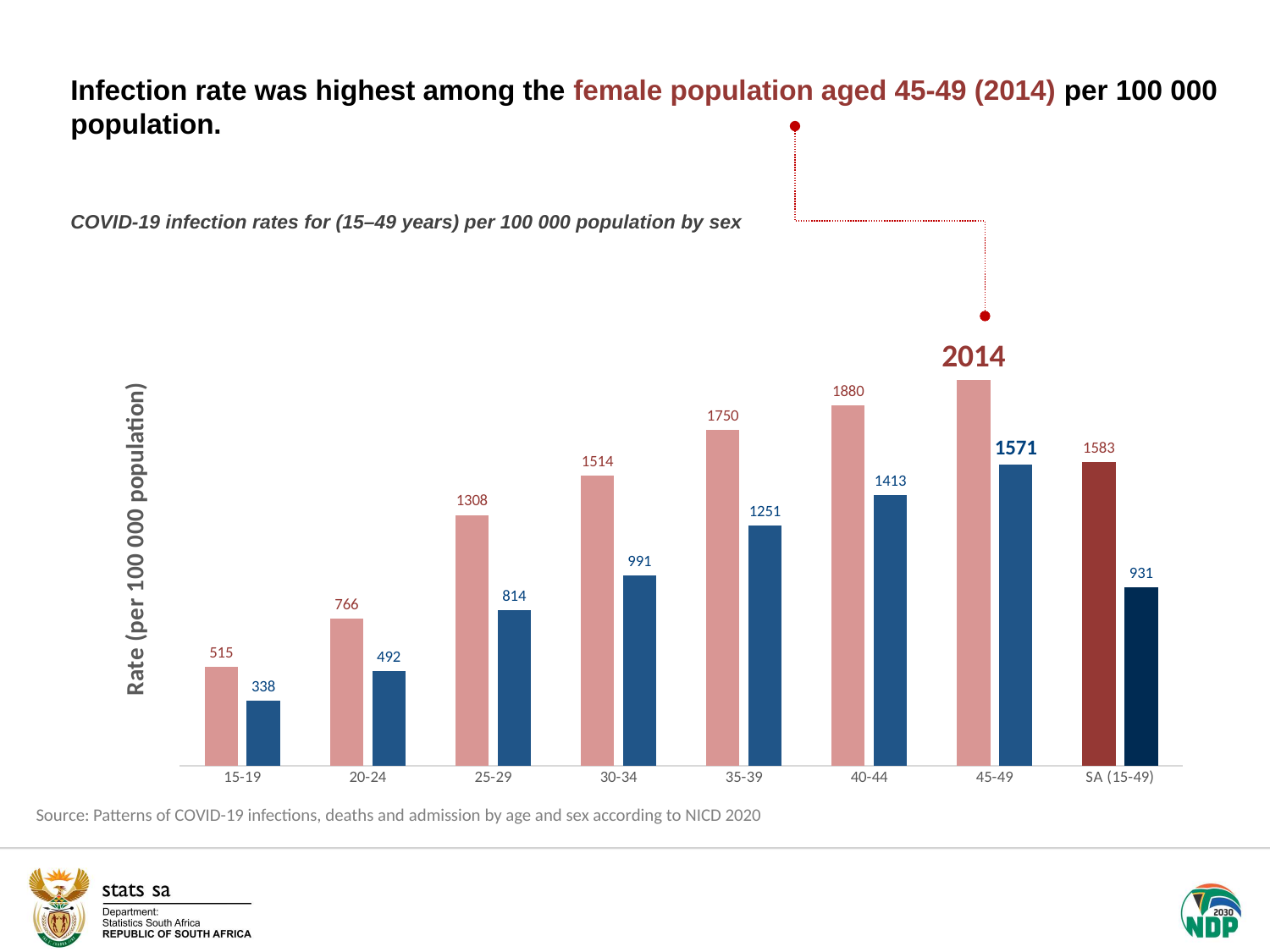
Which age group has the highest female infection rate? 45-49 Which is larger, the male rate for 45-49 or the female rate for 30-34? Male rate for 45-49 What is the difference between the female infection rates for the 35-39 and 30-34 age groups? 236 Which age group has the lowest male infection rate? 15-19 What is the y-axis label of the chart? Rate (per 100 000 population) What is the male infection rate for the 30-34 age group? 991 How many age-group categories are shown on the x axis? 8 What kind of chart is shown on the slide? Bar chart What is the difference between the female and male infection rates for the 40-44 age group? 467 What is the female infection rate for the SA (15-49) category? 1583 What is the female infection rate for the 45-49 age group? 2014 Do the female infection rates rise or fall from the 15-19 to the 45-49 age group? Rise